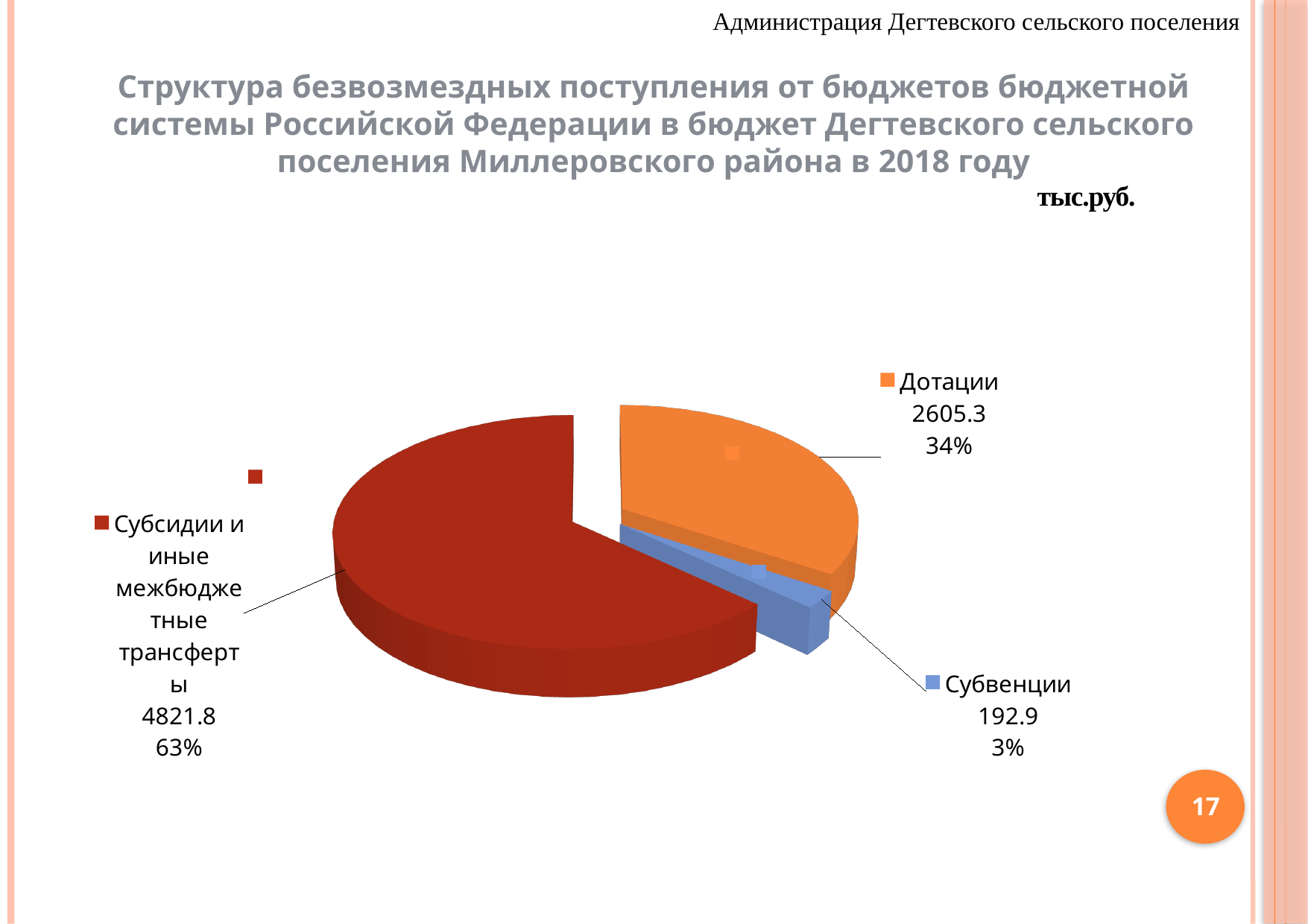
What share of the pie does Субвенции represent? 3% Which category has the smallest value? Субвенции How many slices does the pie chart have? 3 What is the value for Субсидии и иные межбюджетные трансферты? 4821.8 Which is larger, Дотации or Субвенции? Дотации What is the difference between the values for Дотации and Субвенции? 2412.4 What is the value for Дотации? 2605.3 What share of the pie does Субсидии и иные межбюджетные трансферты represent? 63% What share of the pie does Дотации represent? 34% What type of chart is shown on the slide? pie chart What is the value for Субвенции? 192.9 Which category has the largest value? Субсидии и иные межбюджетные трансферты